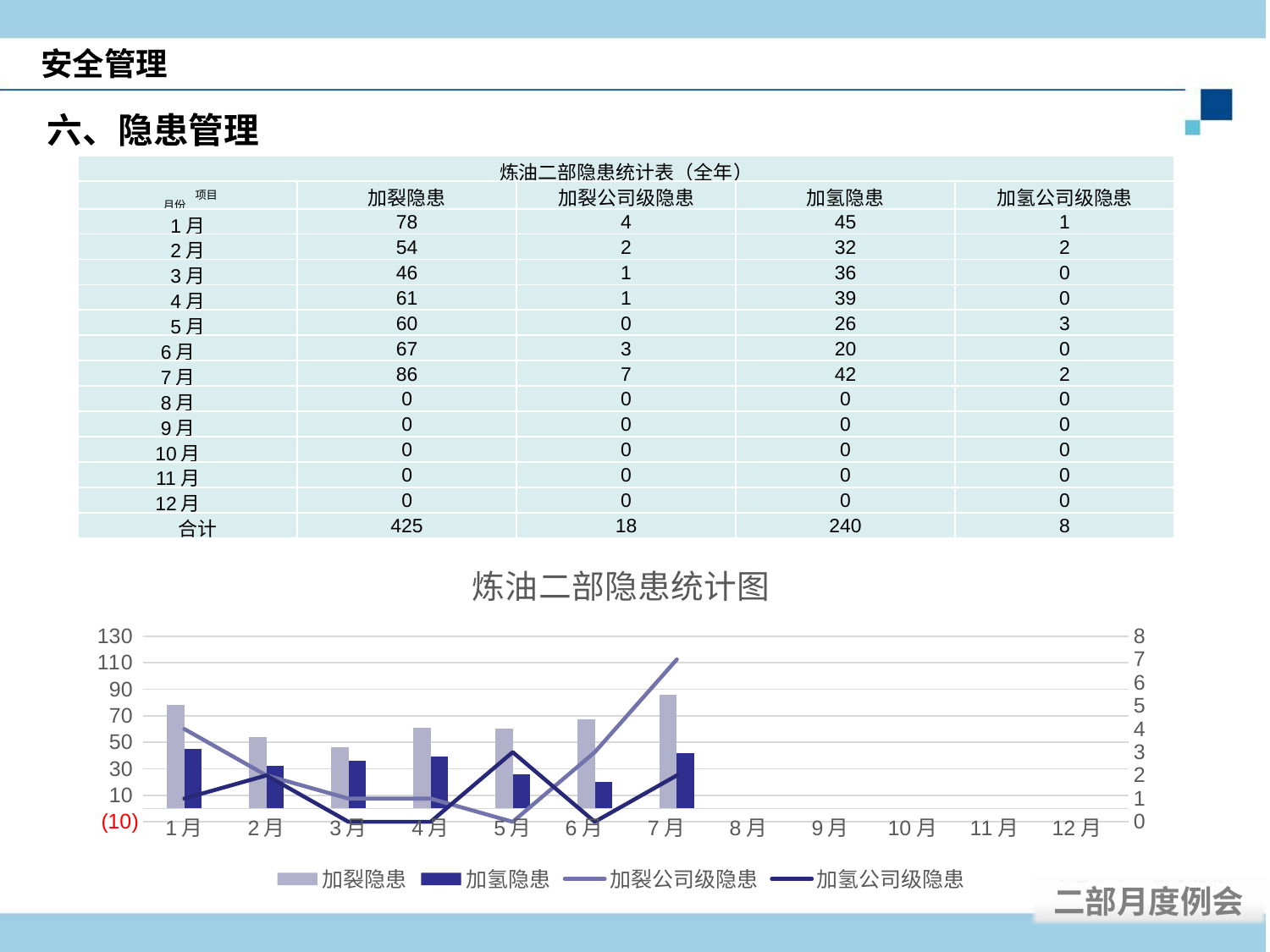
Does the 加裂公司级隐患 line rise or fall from 5月 to 7月? rise In the 炼油二部隐患统计图, which month has the tallest 加裂隐患 bar? 7月 How many series does the legend of the 炼油二部隐患统计图 list? 4 What kind of chart is the 炼油二部隐患统计图? A combined bar and line chart What is the difference between the 加裂隐患 values for 7月 and 1月? 8 Among 1月 to 7月, which month has the lowest 加氢隐患 bar? 6月 In the 炼油二部隐患统计图, is the 加氢隐患 value for 6月 greater or less than 30? less How many months are shown on the x axis of the 炼油二部隐患统计图? 12 In 4月, which is larger, 加裂隐患 or 加氢隐患? 加裂隐患 What is the 加裂公司级隐患 value for 7月? 7 What is the 加裂隐患 value for 7月? 86 In the 炼油二部隐患统计图, is the 加裂隐患 value for 1月 greater or less than 70? greater